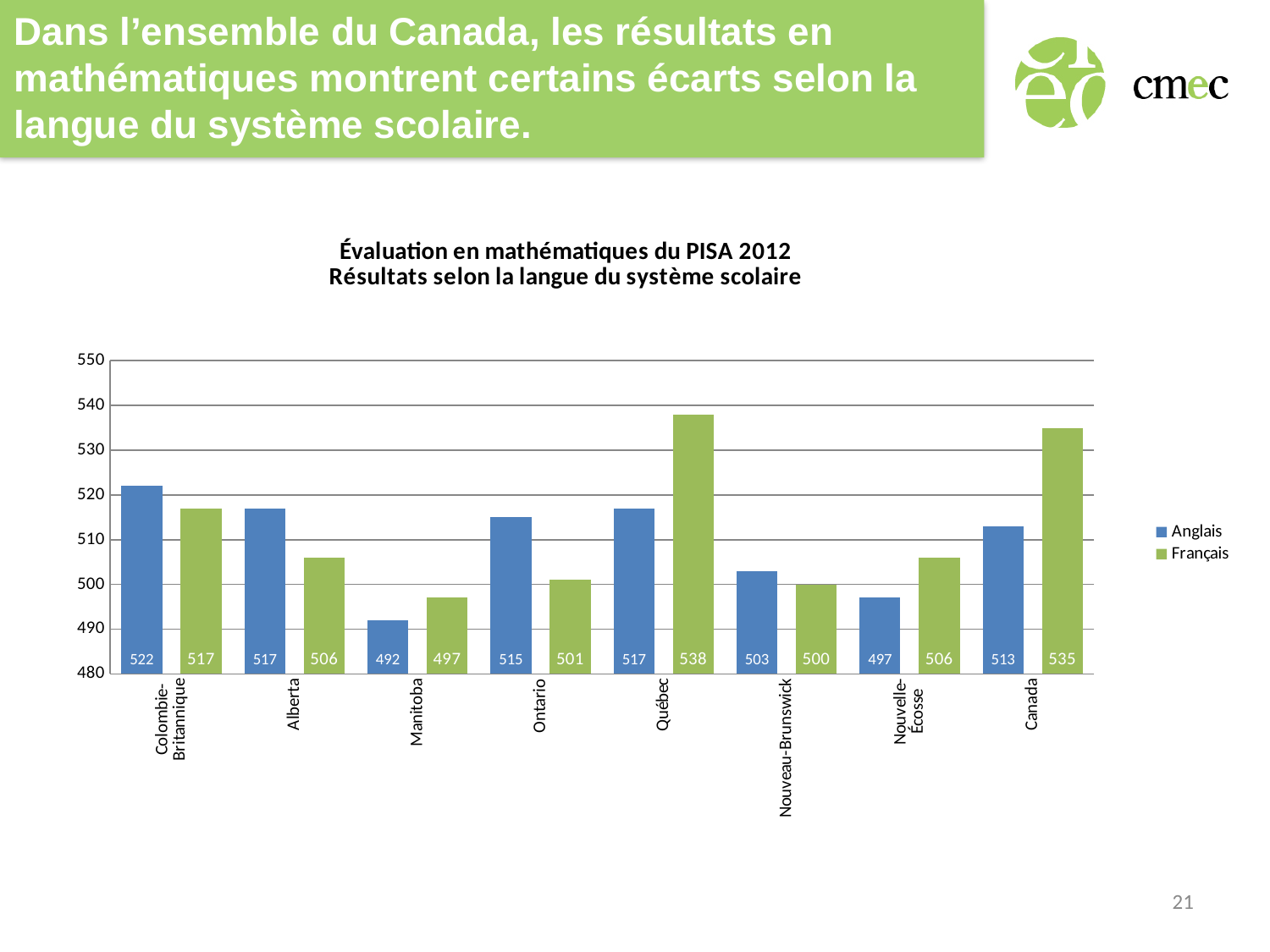
What is the title of the chart? Évaluation en mathématiques du PISA 2012 Résultats selon la langue du système scolaire What is the Anglais value for Manitoba? 492 Which category has the lowest Anglais value? Manitoba How many categories are shown on the x axis? 8 What is the Anglais value for Colombie-Britannique? 522 How many series does the legend list? 2 What kind of chart is shown on the slide? bar chart What is the Français value for Québec? 538 Is the Français value for Québec greater or less than 530? greater For Alberta, which is larger, the Anglais value or the Français value? Anglais What is the difference between the Français and Anglais values for Canada? 22 Which category has the highest Français value? Québec